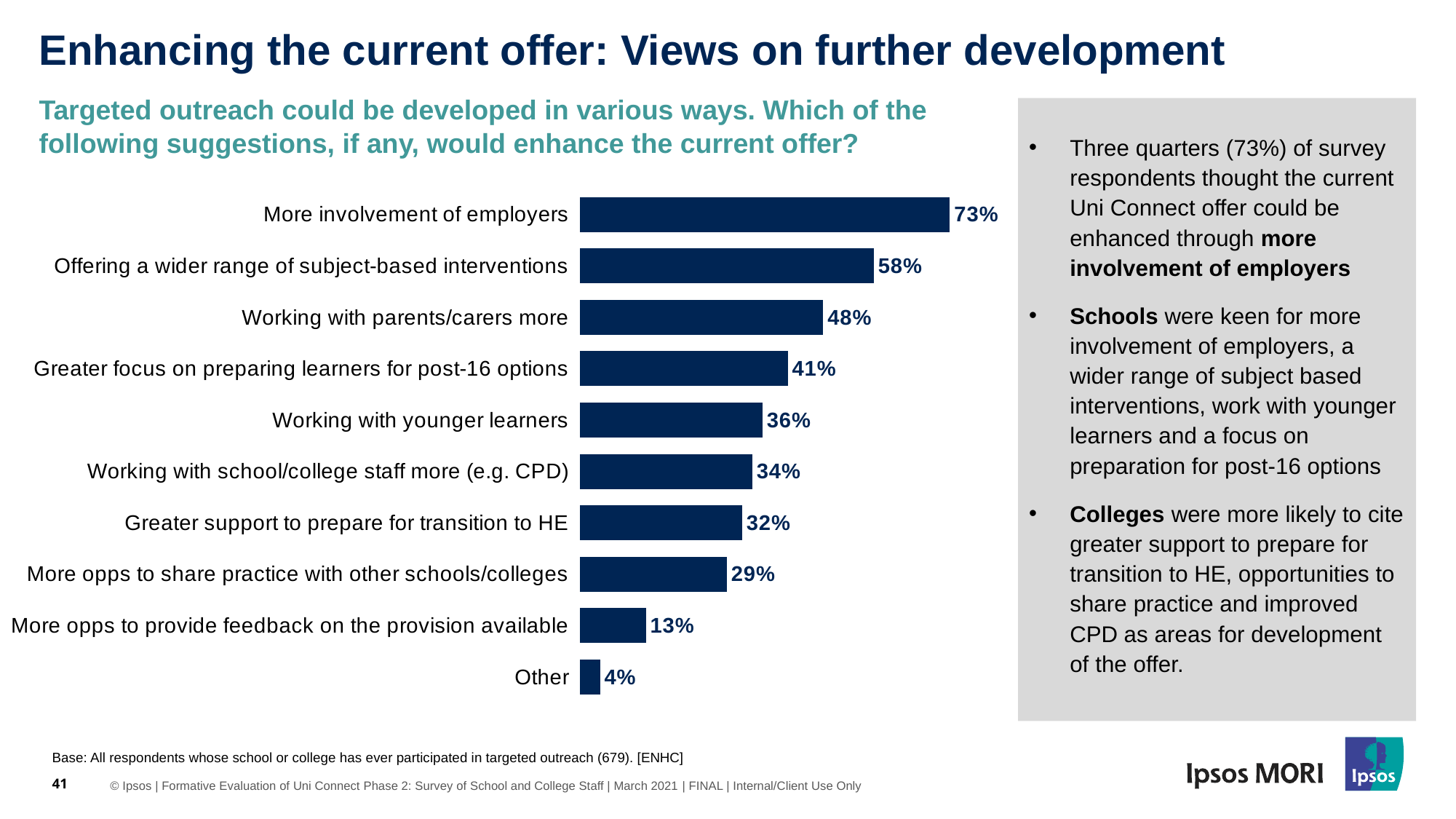
Which is larger: 'Working with school/college staff more (e.g. CPD)' or 'More opps to share practice with other schools/colleges'? Working with school/college staff more (e.g. CPD) What percentage is shown for 'More opps to provide feedback on the provision available'? 13% What colour are the bars in the chart? Dark navy blue What type of chart is shown on the slide? Bar chart What is the value for 'Working with parents/carers more'? 48% How many categories are shown in the bar chart? 10 What is the difference between 'More involvement of employers' and 'Offering a wider range of subject-based interventions'? 15 percentage points What is the difference between 'Working with younger learners' and 'Greater support to prepare for transition to HE'? 4 percentage points What percentage of respondents selected 'More involvement of employers'? 73% What is the value for 'Greater focus on preparing learners for post-16 options'? 41% Which category has the lowest percentage? Other Which suggestion has the highest percentage? More involvement of employers